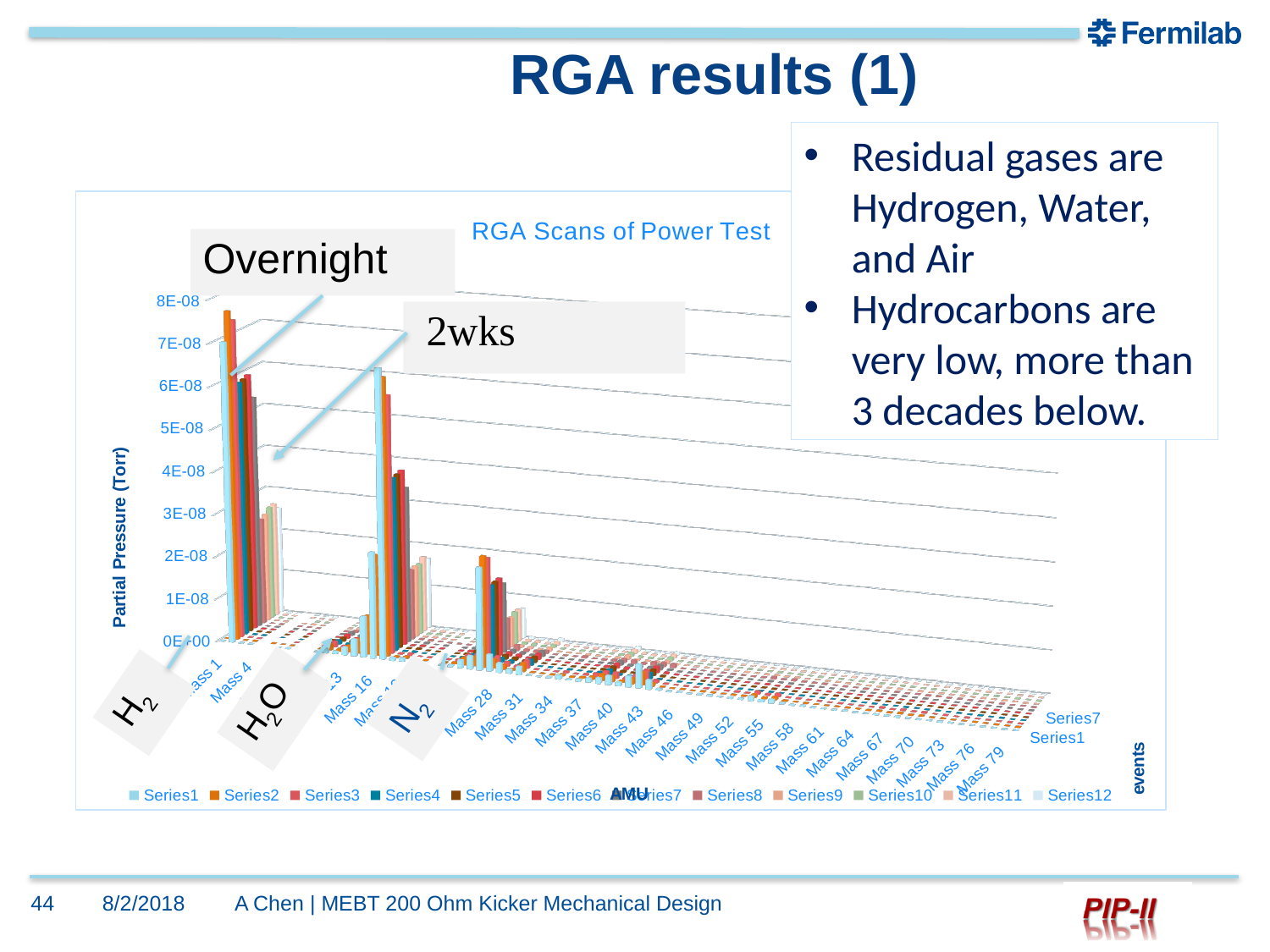
Is the tallest bar at Mass 55 greater or less than 1E-08 Torr? less What is the label of the vertical axis of the chart? Partial Pressure (Torr) Overall, do the partial pressures rise or fall as the mass increases from Mass 1 to Mass 79? fall What is the title of the chart? RGA Scans of Power Test What kind of chart is shown on the slide? bar chart Which annotated gas has the tallest bars in the chart? H2 How many series does the chart legend list? 12